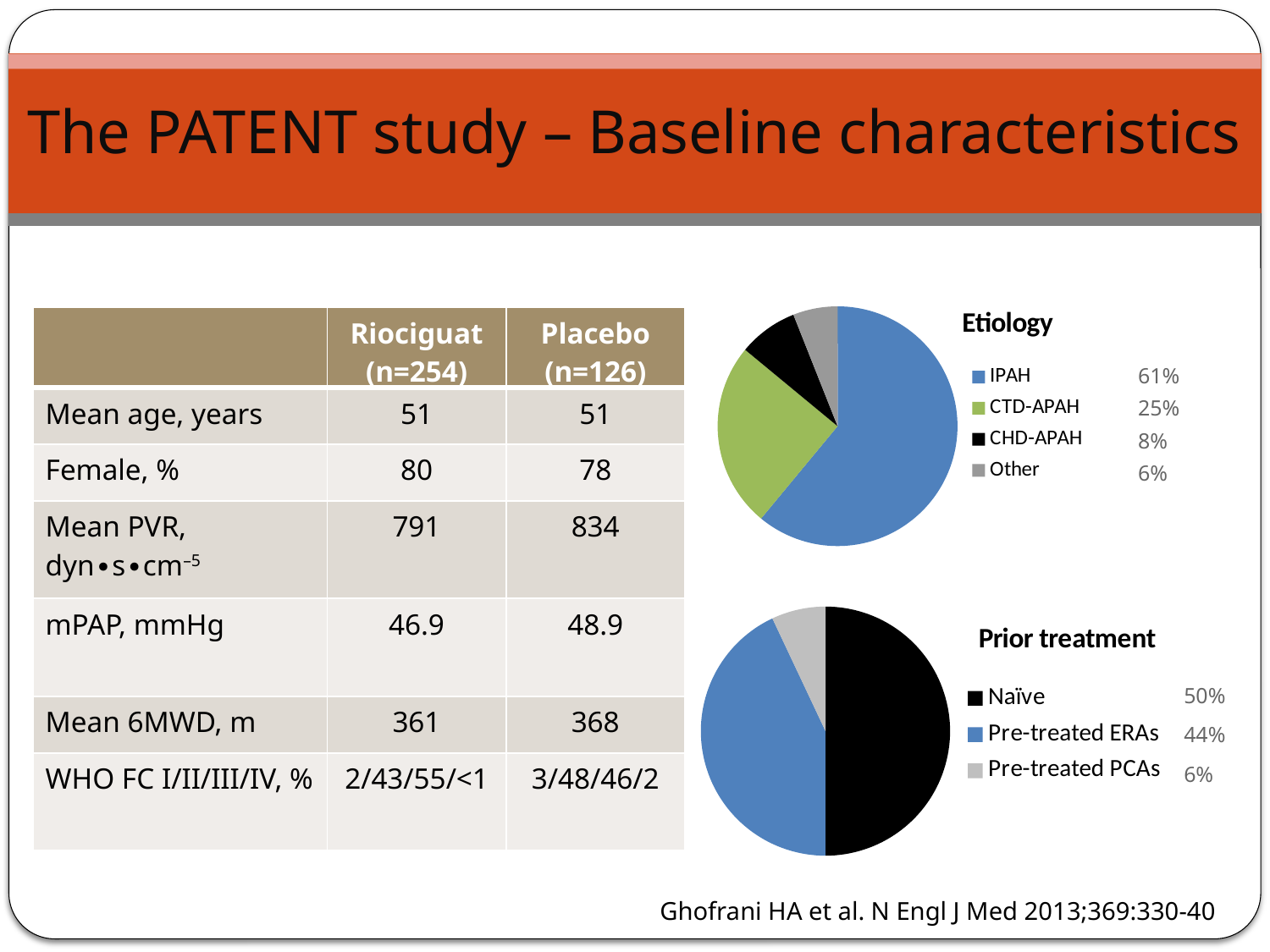
In the Prior treatment pie chart, what share is Pre-treated PCAs? 6% How many categories does the Etiology pie chart show? 4 In the Etiology pie chart, what share does IPAH have? 61% In the Prior treatment pie chart, what is the difference between the Pre-treated ERAs and Pre-treated PCAs shares? 38% In the Etiology pie chart, which category has the largest share? IPAH In the Etiology pie chart, what colour is the CHD-APAH slice? Black In the Prior treatment pie chart, what share is Naïve? 50% In the Etiology pie chart, what is the difference between the IPAH and CTD-APAH shares? 36% What type of chart is the Prior treatment chart? Pie chart In the Etiology pie chart, which category has the smallest share? Other In the Prior treatment pie chart, which is larger, Naïve or Pre-treated ERAs? Naïve